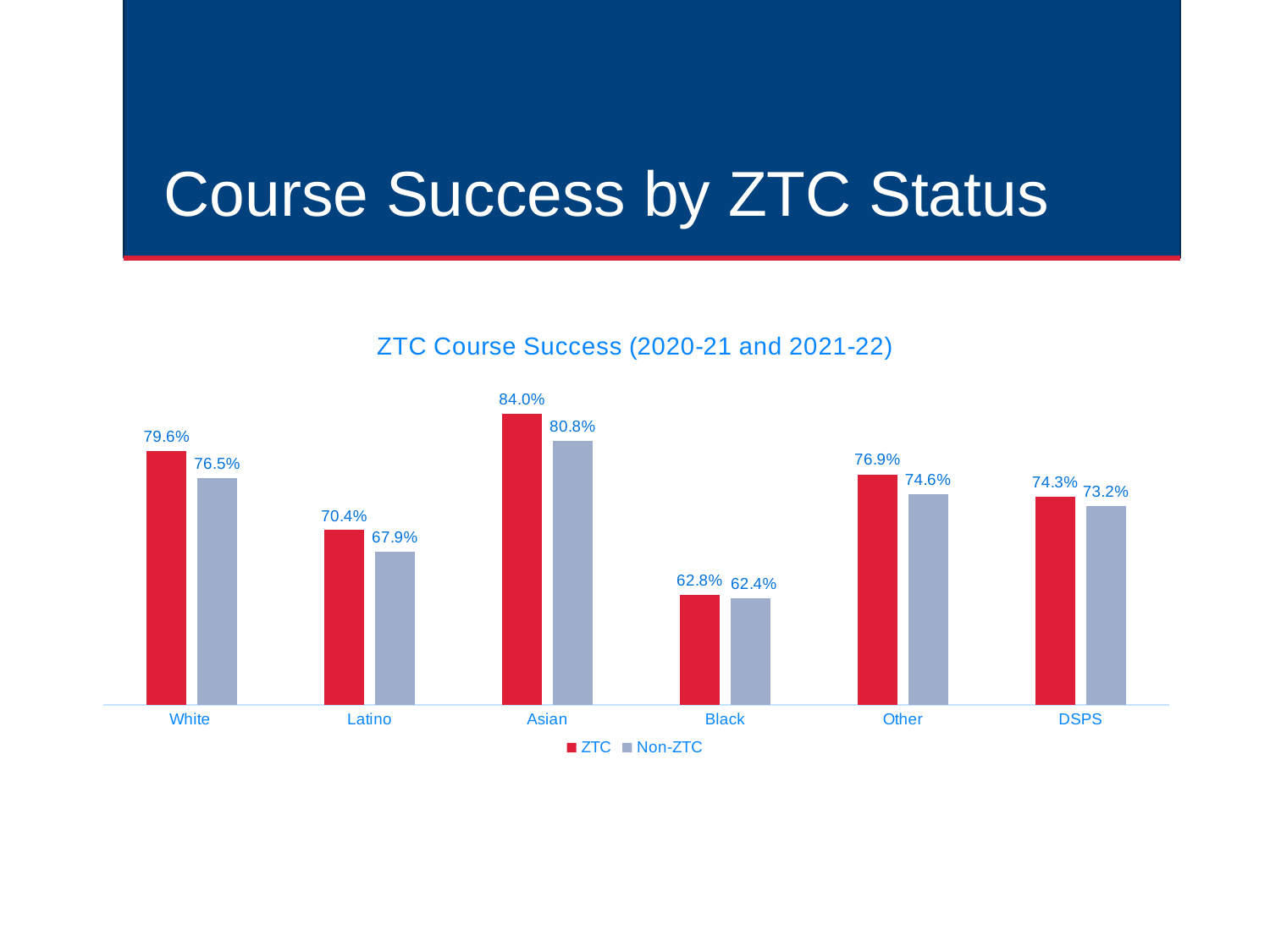
What is the difference between the ZTC values for Asian and Black students? 21.2% Which category has the lowest Non-ZTC course success rate? Black Which category has the highest ZTC course success rate? Asian Which is larger, the ZTC value for Other or the Non-ZTC value for Other? ZTC (76.9%) What is the Non-ZTC course success rate for Latino students? 67.9% What is the difference between the ZTC and Non-ZTC values for White students? 3.1% How many series does the legend list? 2 What kind of chart is shown on the slide? Bar chart How many categories are shown on the x axis? 6 What is the title of the chart? ZTC Course Success (2020-21 and 2021-22) What is the ZTC value for DSPS? 74.3% What is the ZTC course success rate for Asian students? 84.0%